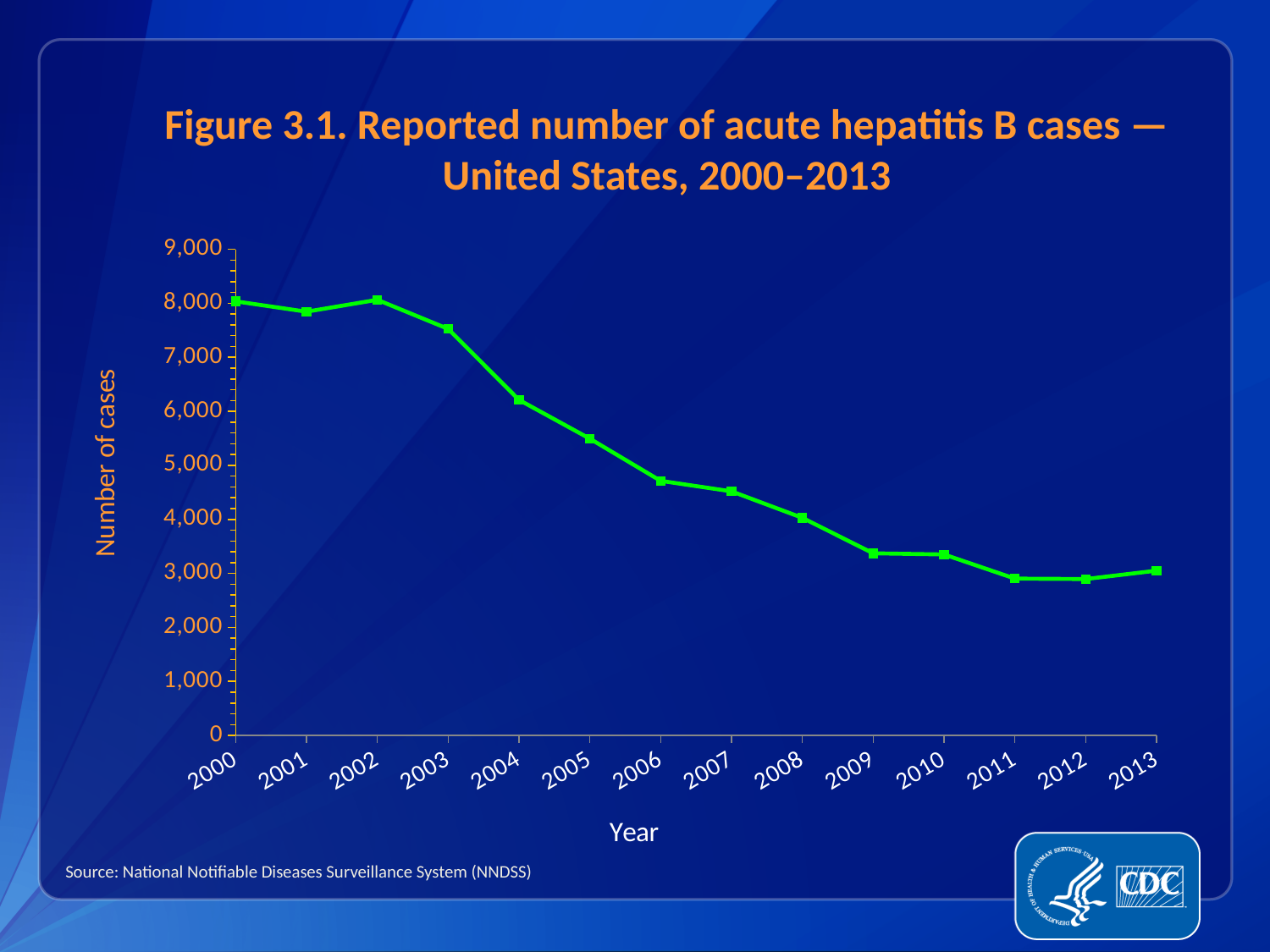
Is the number of cases in 2001 greater or less than 8,000? less Which year had more reported cases, 2000 or 2013? 2000 Is the number of cases in 2006 greater or less than 5,000? less Is the number of cases in 2003 greater or less than 7,000? greater Which year had more reported cases, 2004 or 2008? 2004 What is the label on the vertical axis of the chart? Number of cases What kind of chart is shown on the slide? Line chart Overall, do the reported acute hepatitis B cases rise or fall from 2000 to 2013? Fall How many years (data points) are plotted on the chart? 14 What is the label on the horizontal axis of the chart? Year